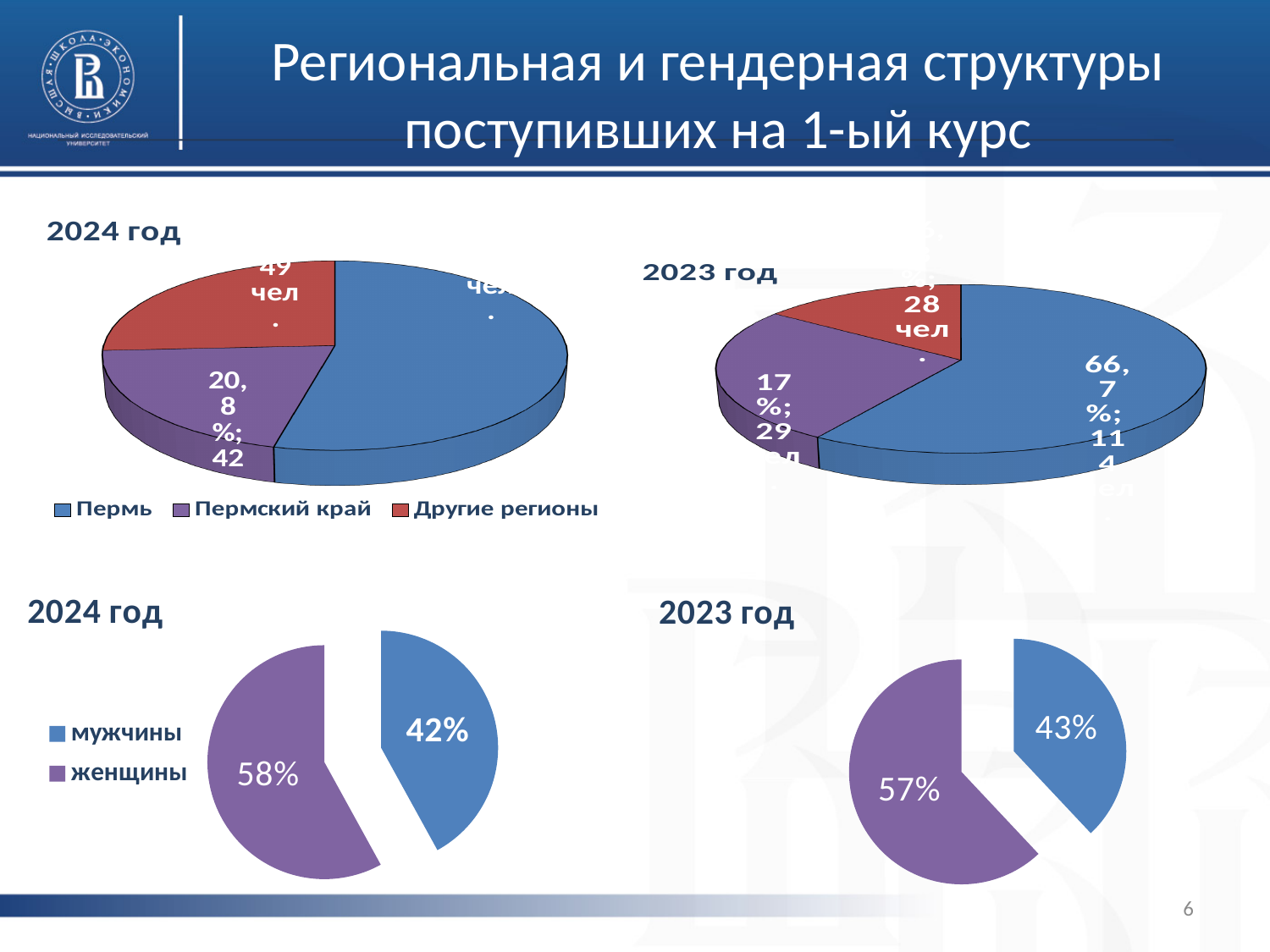
In the top-left regional pie chart for 2024 год, what percentage is labelled for Пермский край? 20,8% In the bottom-left gender pie chart for 2024 год, what share is labelled for женщины? 58% In the top-right regional pie chart for 2023 год, which region has the largest slice? Пермь In the top-right regional pie chart for 2023 год, what percentage is labelled for Пермь? 66,7% In the bottom-left gender pie chart for 2024 год, what is the difference between the shares of женщины and мужчины? 16% In the bottom-left gender pie chart for 2024 год, which group has the larger share, мужчины or женщины? женщины In the top-left regional pie chart for 2024 год, how many people are labelled for Другие регионы? 49 чел. In the bottom-right gender pie chart for 2023 год, what share is labelled for женщины? 57% How many categories does the legend of the top regional pie charts list? 3 In the bottom-left gender pie chart for 2024 год, what share is labelled for мужчины? 42% In the bottom-right gender pie chart for 2023 год, what is the difference between the shares of женщины and мужчины? 14% In the bottom-right gender pie chart for 2023 год, what share is labelled for мужчины? 43%